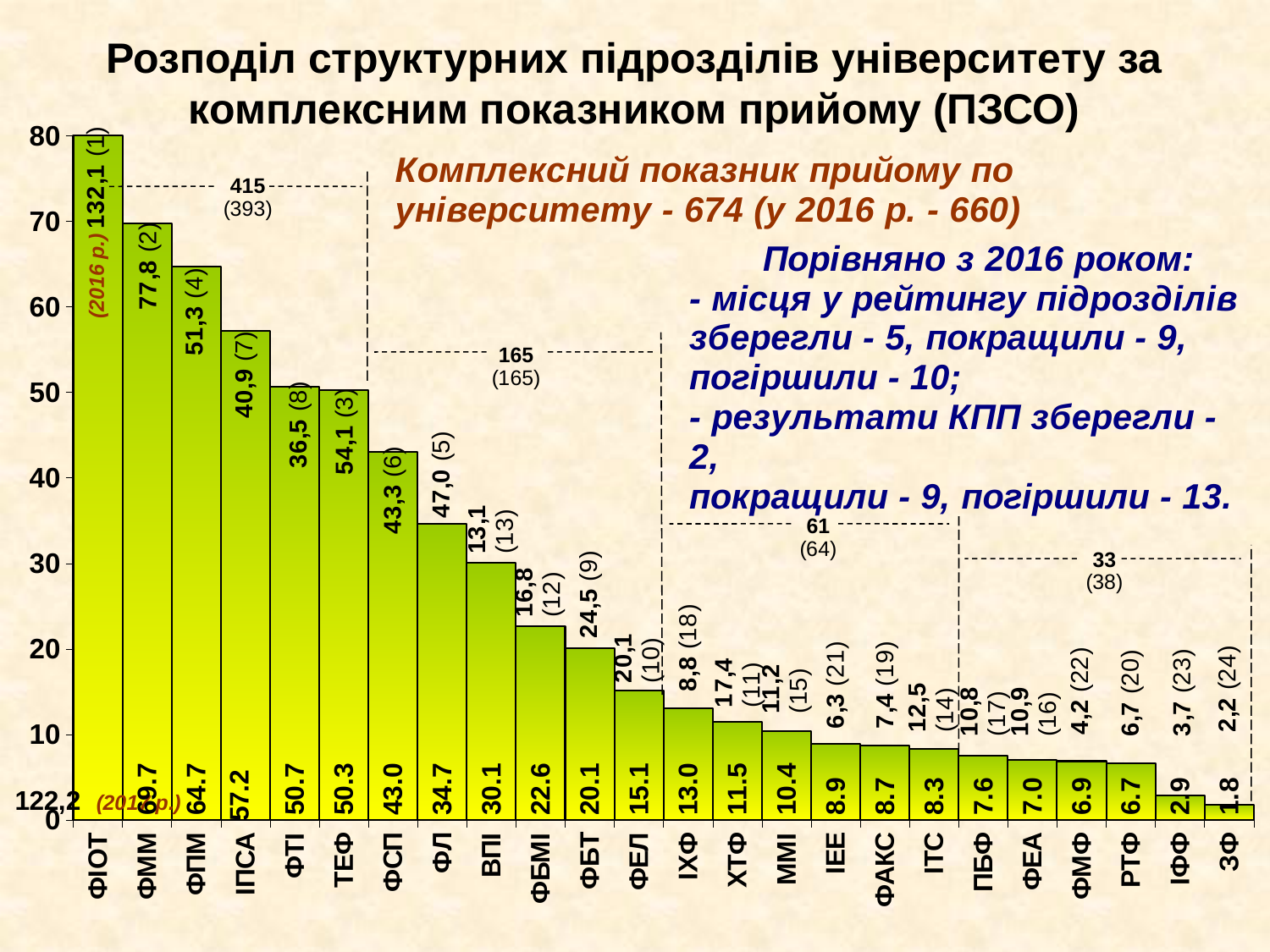
What is the value shown for ФСП? 43.0 What is the value shown for ЗФ? 1.8 What is the difference between the values for ФММ and ФПМ? 5.0 Do the values rise or fall moving from left to right along the x axis? fall Which unit has the lowest value in the chart? ЗФ Which is larger, the value for ФЛ or the value for ВПІ? ФЛ What is the value shown for ФММ? 69.7 What was the 2016 value shown for ФММ (the upper label on its bar)? 77,8 Which unit has the highest value in the chart? ФІОТ How many structural units (categories) are shown on the x axis of the chart? 24 What is the group total printed above the first group of bars (ФІОТ to ТЕФ)? 415 What kind of chart is shown on the slide? bar chart